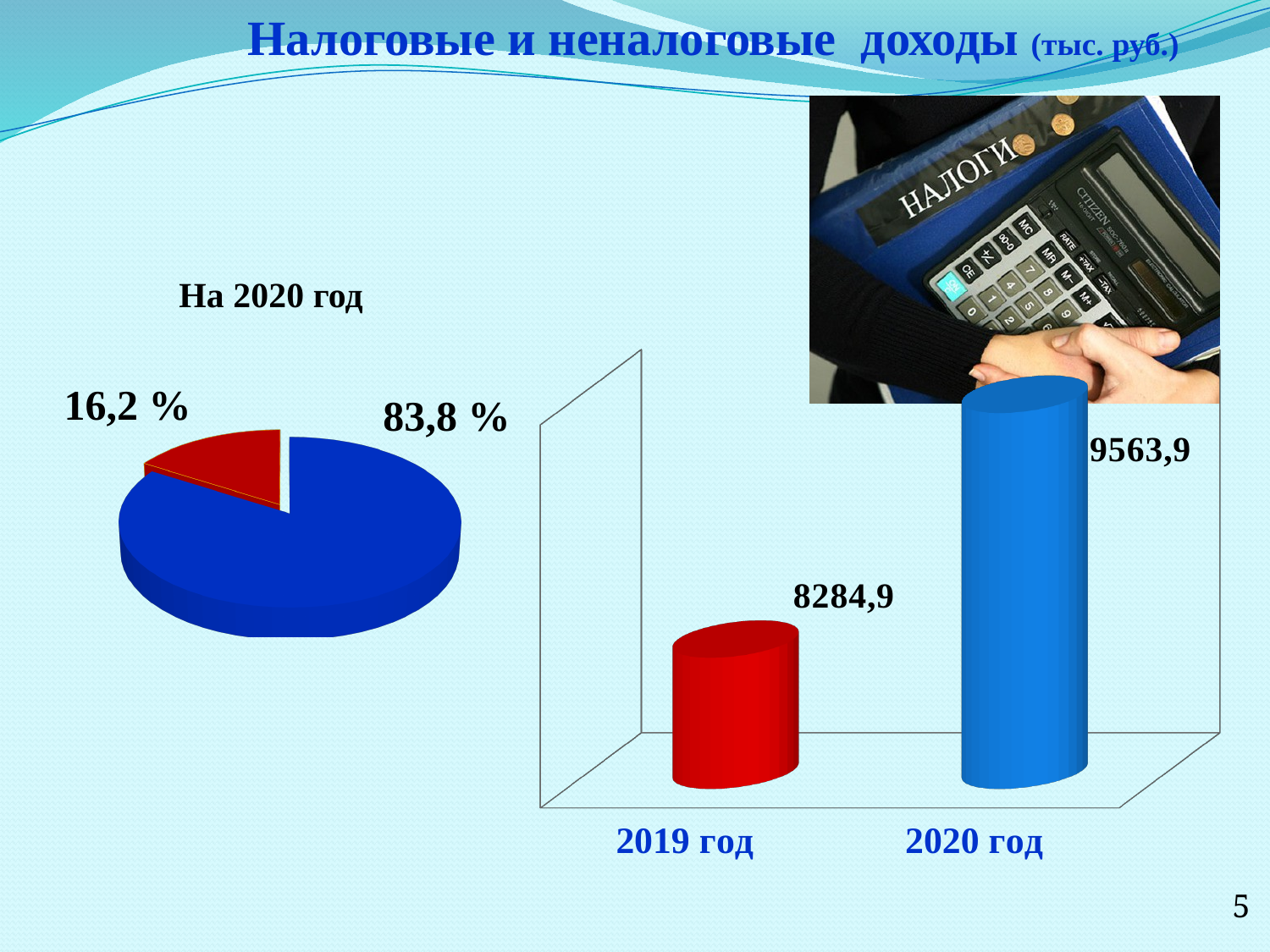
On the bar chart on the right, how many bars are shown? 2 On the bar chart on the right, is the value for 2020 год larger or smaller than the value for 2019 год? larger On the bar chart on the right, by how much does the value for 2020 год exceed the value for 2019 год? 1279,0 On the bar chart on the right, do the values rise or fall from 2019 год to 2020 год? rise What kind of chart is shown on the left side of the slide under 'На 2020 год'? pie chart On the bar chart on the right, which year has the lower value? 2019 год On the pie chart titled 'На 2020 год', what share does the blue slice represent? 83,8 % On the pie chart titled 'На 2020 год', what share does the red slice represent? 16,2 % On the bar chart on the right, what is the value for 2020 год? 9563,9 On the bar chart on the right, what is the value for 2019 год? 8284,9 What kind of chart is shown on the right side of the slide? bar chart On the bar chart on the right, which year has the higher value? 2020 год